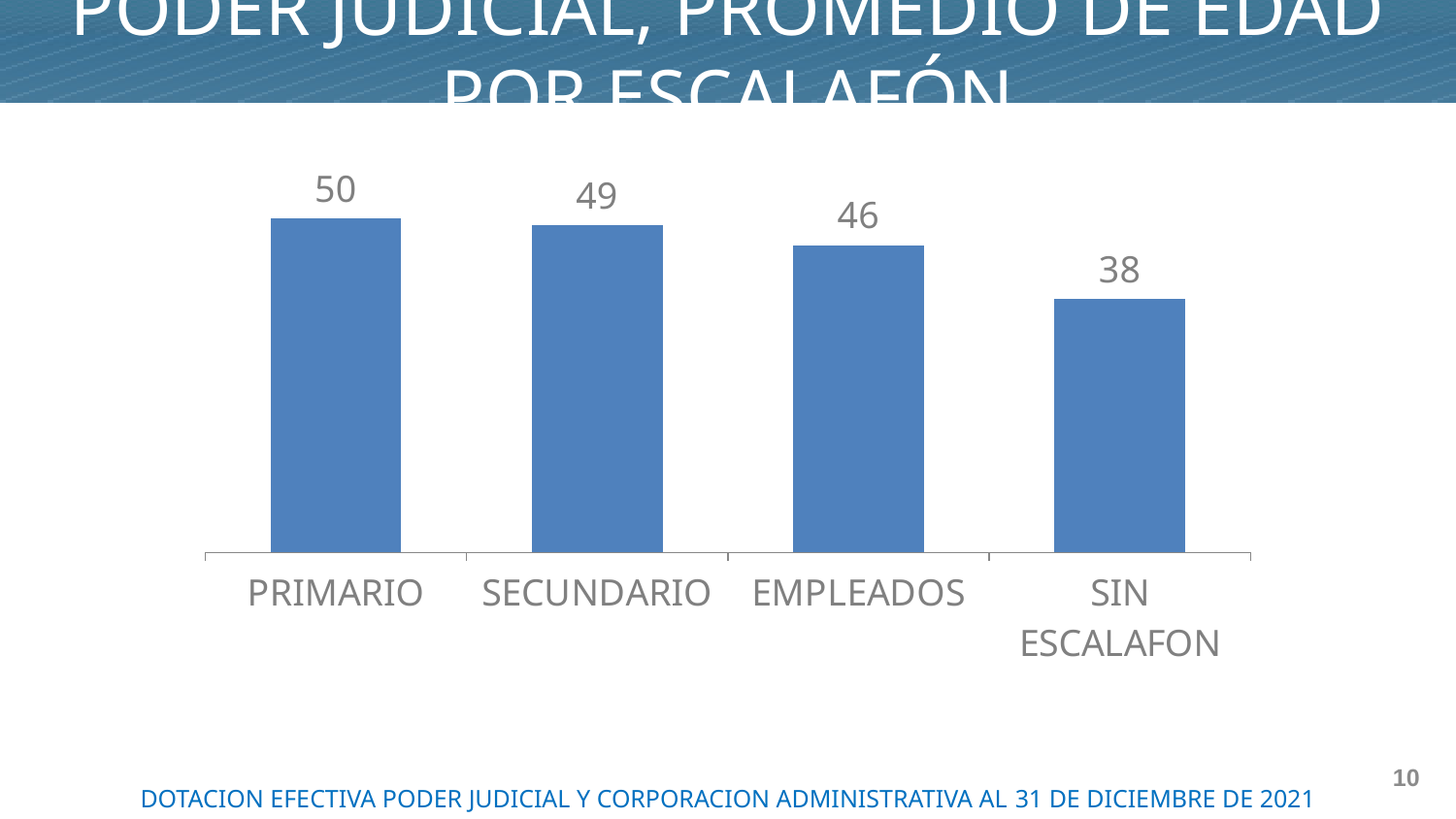
What is the difference between the average age for SECUNDARIO and EMPLEADOS? 3 What is the difference between the average age for PRIMARIO and SIN ESCALAFON? 12 Do the values rise or fall from left to right across the categories? Fall Which has a higher average age, EMPLEADOS or SIN ESCALAFON? EMPLEADOS What is the average age shown for SIN ESCALAFON? 38 Which category has the highest average age? PRIMARIO What is the average age shown for SECUNDARIO? 49 What kind of chart is shown on the slide? Bar chart What is the average age shown for PRIMARIO? 50 What is the average age shown for EMPLEADOS? 46 How many categories are shown in the chart? 4 Which category has the lowest average age? SIN ESCALAFON